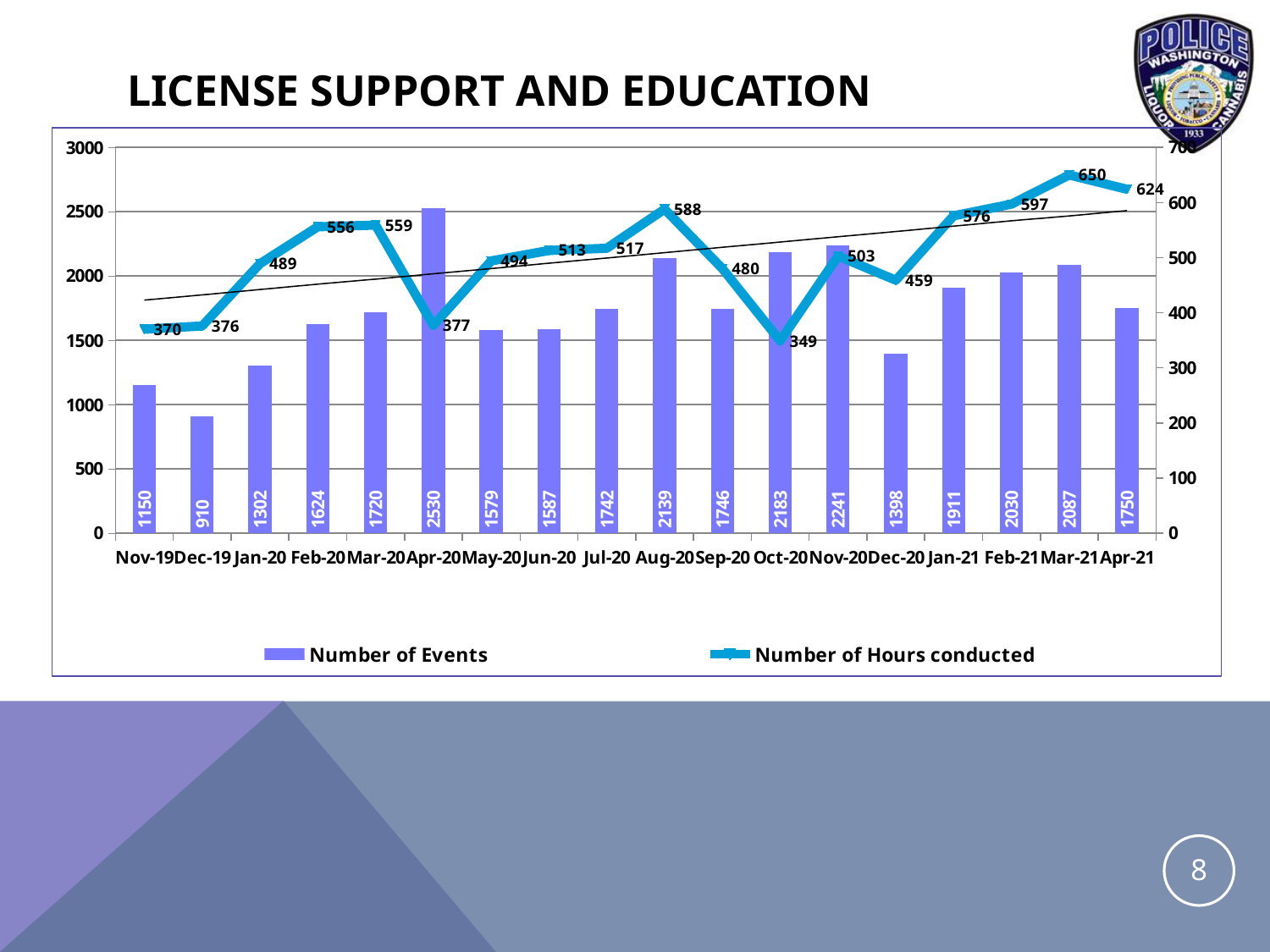
What is the difference in Number of Hours conducted between Mar-21 and Apr-21? 26 What is the title of the slide containing the chart? LICENSE SUPPORT AND EDUCATION Which month has more Number of Events, Nov-20 or Oct-20? Nov-20 How many series does the legend list? 2 What kind of chart is used to show the Number of Events? Bar chart Which month has the highest Number of Hours conducted? Mar-21 What is the Number of Events for Dec-20? 1398 Which month has the lowest Number of Events? Dec-19 What is the Number of Events for Apr-20? 2530 What is the difference in Number of Events between Apr-20 and Dec-19? 1620 How many months are shown on the x axis? 18 What is the Number of Hours conducted for Oct-20? 349